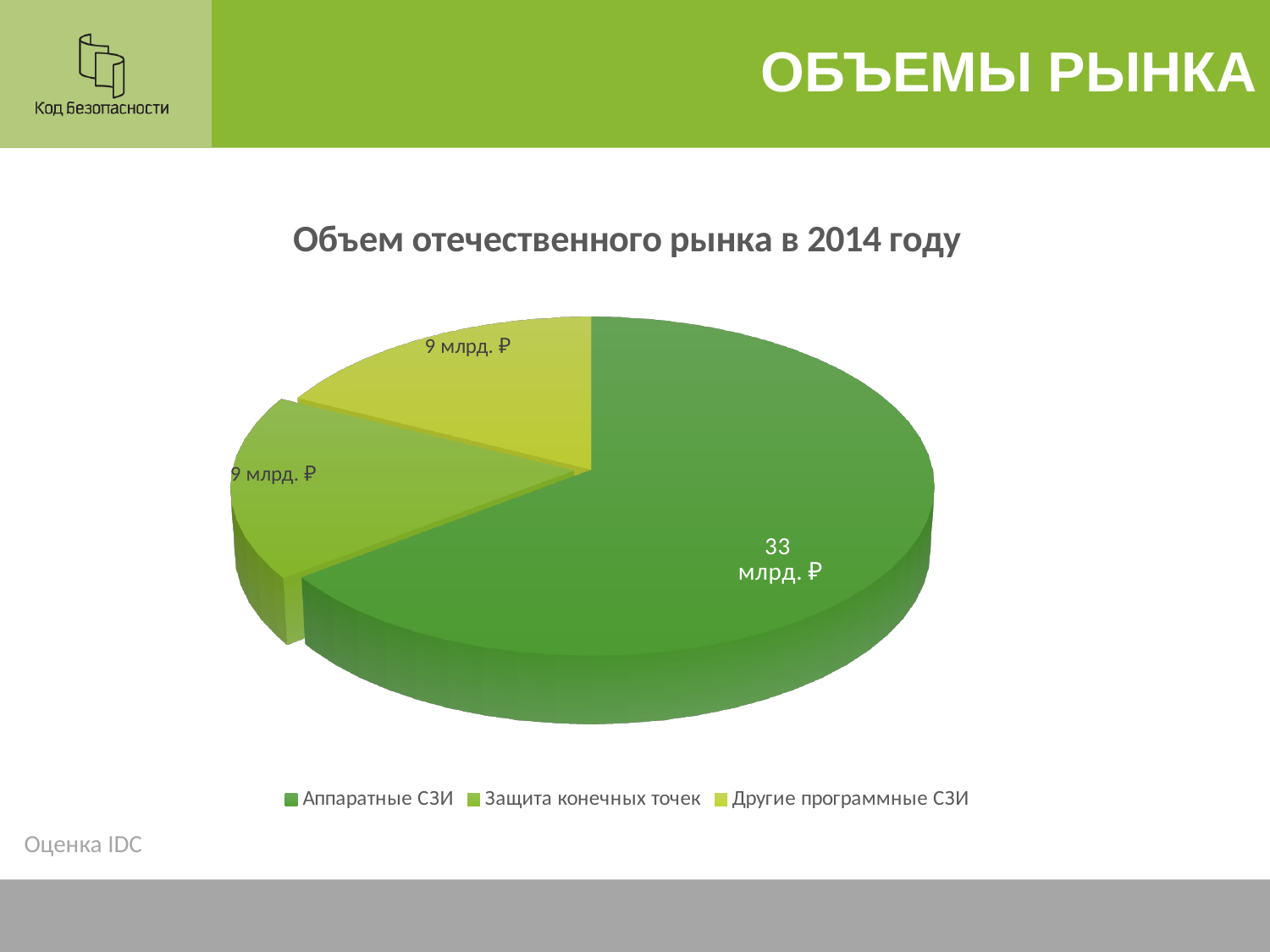
What is the value for Другие программные СЗИ? 9 млрд. ₽ What is the title of the chart? Объем отечественного рынка в 2014 году What is the value for Защита конечных точек? 9 млрд. ₽ Which is larger, Аппаратные СЗИ or Защита конечных точек? Аппаратные СЗИ What is the value for Аппаратные СЗИ? 33 млрд. ₽ Which category is shown in the yellow-green colour in the legend? Другие программные СЗИ How many slices does the pie chart have? 3 Which category has the largest slice of the pie? Аппаратные СЗИ What type of chart is shown on the slide? Pie chart What is the difference between the values for Аппаратные СЗИ and Другие программные СЗИ? 24 млрд. ₽ How many entries does the legend list? 3 What is the total of all slices in the pie chart? 51 млрд. ₽